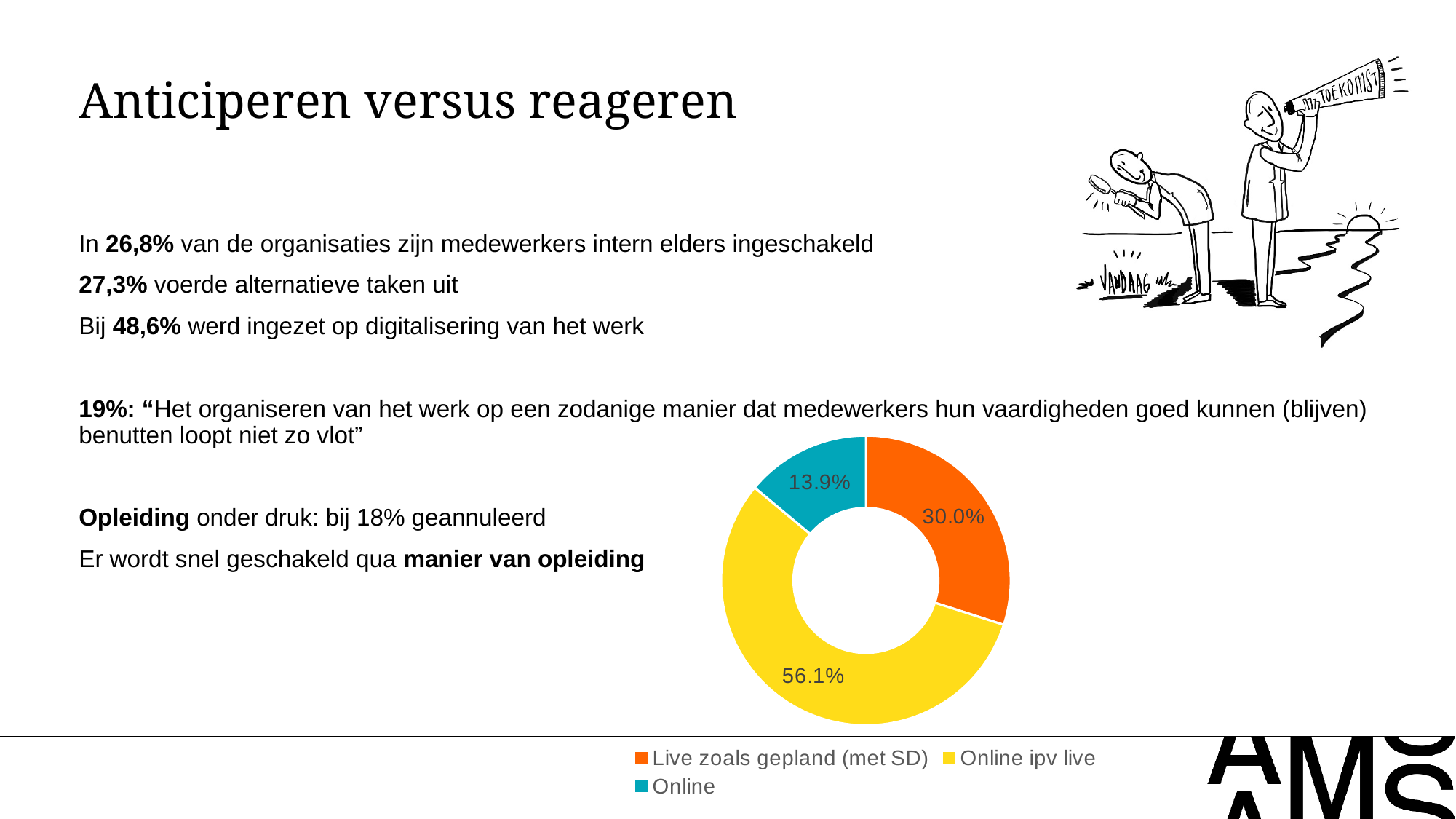
What is the value for "Live zoals gepland (met SD)" in the doughnut chart? 30.0% Which is larger in the doughnut chart: "Live zoals gepland (met SD)" or "Online"? Live zoals gepland (met SD) What kind of chart is shown on the slide? doughnut chart Which category has the largest share in the doughnut chart? Online ipv live What is the difference between the shares of "Live zoals gepland (met SD)" and "Online"? 16.1% What is the difference between the shares of "Online ipv live" and "Live zoals gepland (met SD)"? 26.1% Which colour represents "Online ipv live" in the doughnut chart? yellow How many categories does the doughnut chart show? 3 What is the value for "Online" in the doughnut chart? 13.9% Which category has the smallest share in the doughnut chart? Online What is the value for "Online ipv live" in the doughnut chart? 56.1% How many entries does the legend of the doughnut chart list? 3